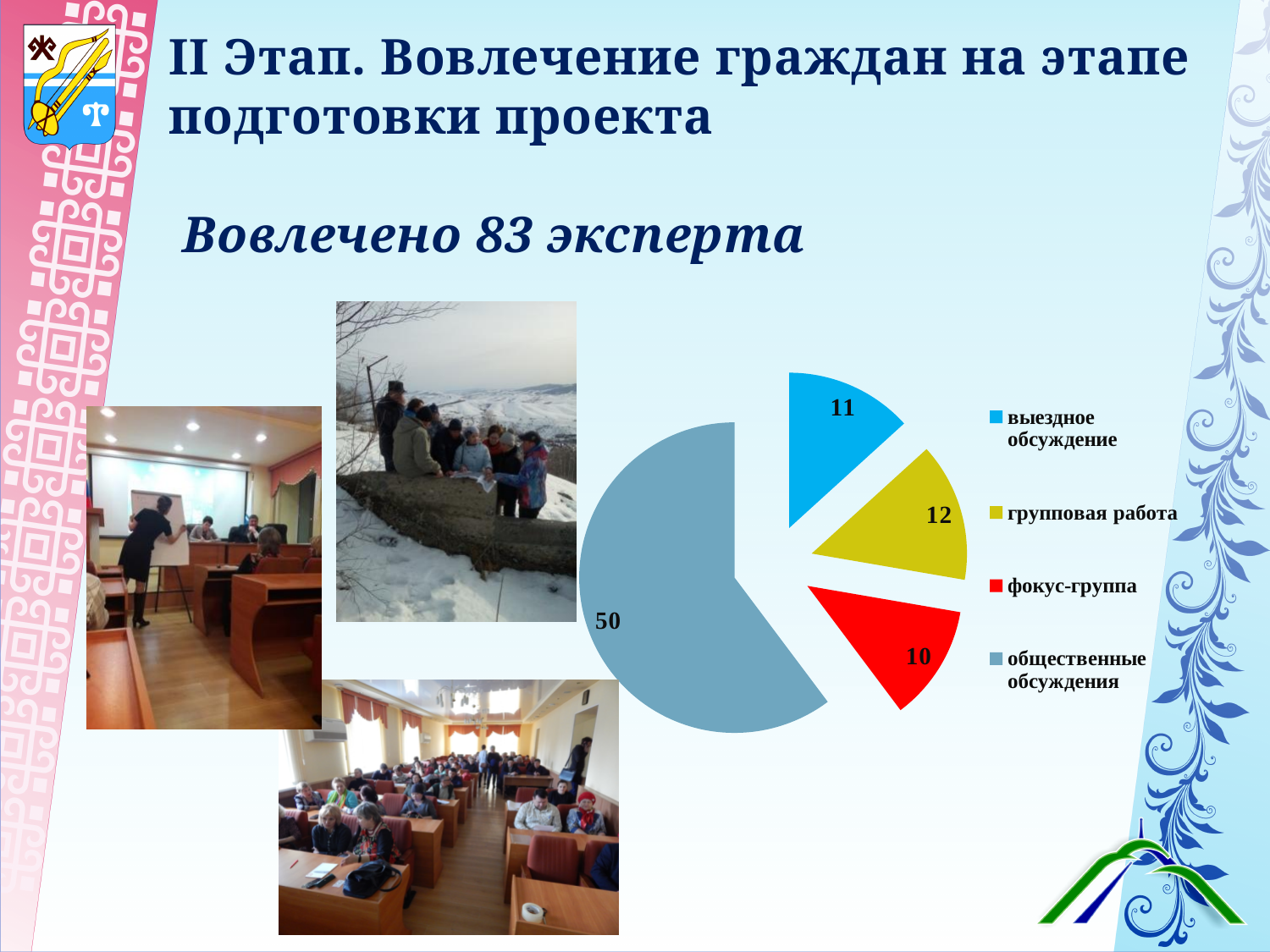
What is the value for "общественные обсуждения" in the pie chart? 50 What is the value for "выездное обсуждение" in the pie chart? 11 Which is larger in the pie chart: "групповая работа" or "фокус-группа"? групповая работа Which category has the largest slice in the pie chart? общественные обсуждения How many entries does the legend of the pie chart list? 4 What kind of chart is shown on the slide? pie chart What colour is the "фокус-группа" slice in the pie chart? red What is the difference between the values for "общественные обсуждения" and "групповая работа"? 38 Which category has the smallest slice in the pie chart? фокус-группа How many slices does the pie chart have? 4 What is the value for "групповая работа" in the pie chart? 12 What is the value for "фокус-группа" in the pie chart? 10